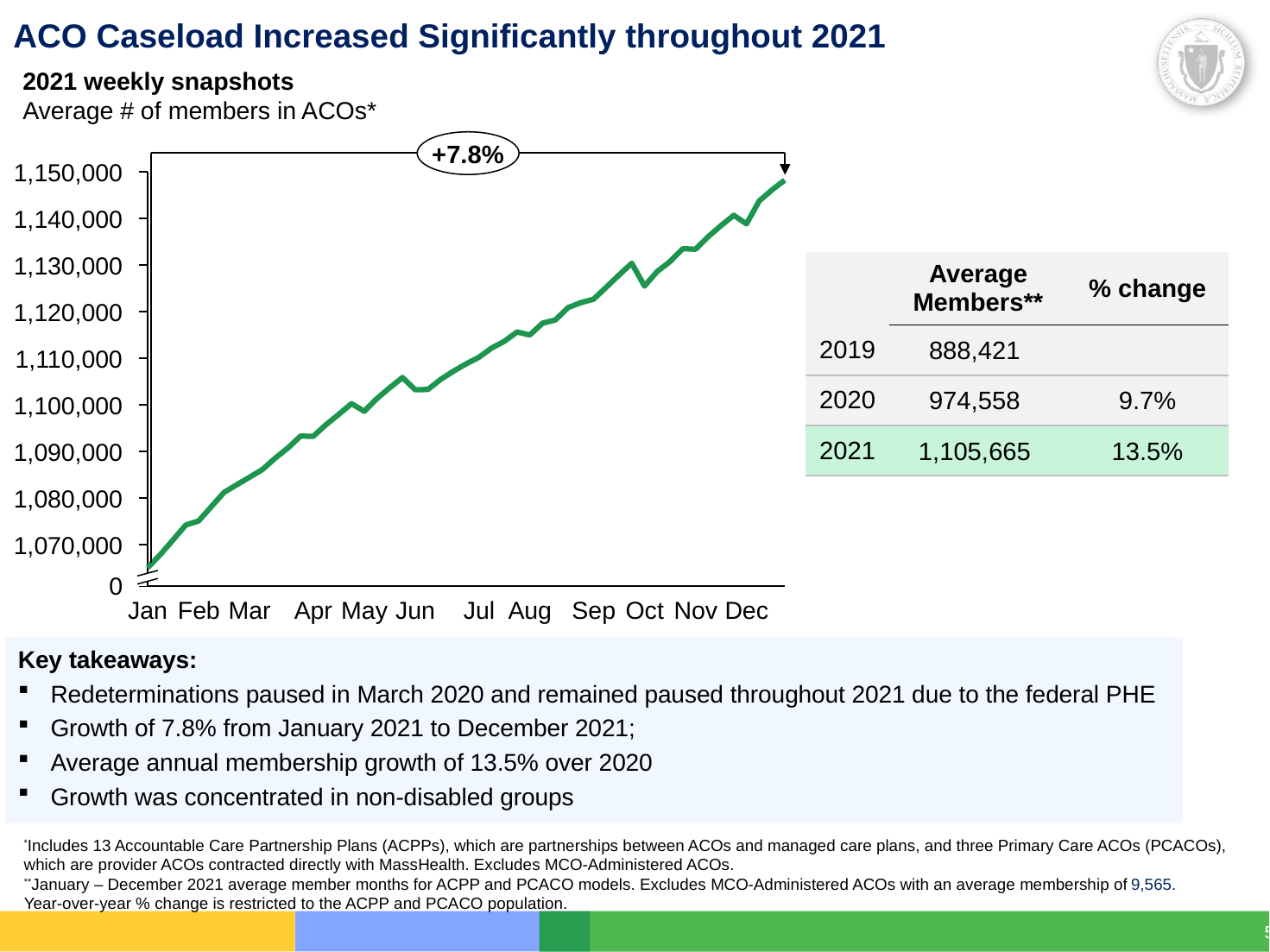
What percentage change is annotated above the line chart? +7.8% Is the value for Jan greater or less than 1,080,000? less Is the value for Mar greater or less than 1,100,000? less Do the values in the line chart rise or fall from January to December? rise What kind of chart is shown on the slide? line chart In which month does the line chart reach its highest value? Dec How many month labels are shown on the x axis of the line chart? 12 What is the title of the line chart? 2021 weekly snapshots In which month does the line chart show its lowest value? Jan Which month has the larger value in the line chart, Jan or Dec? Dec Is the value for Dec greater or less than 1,140,000? greater